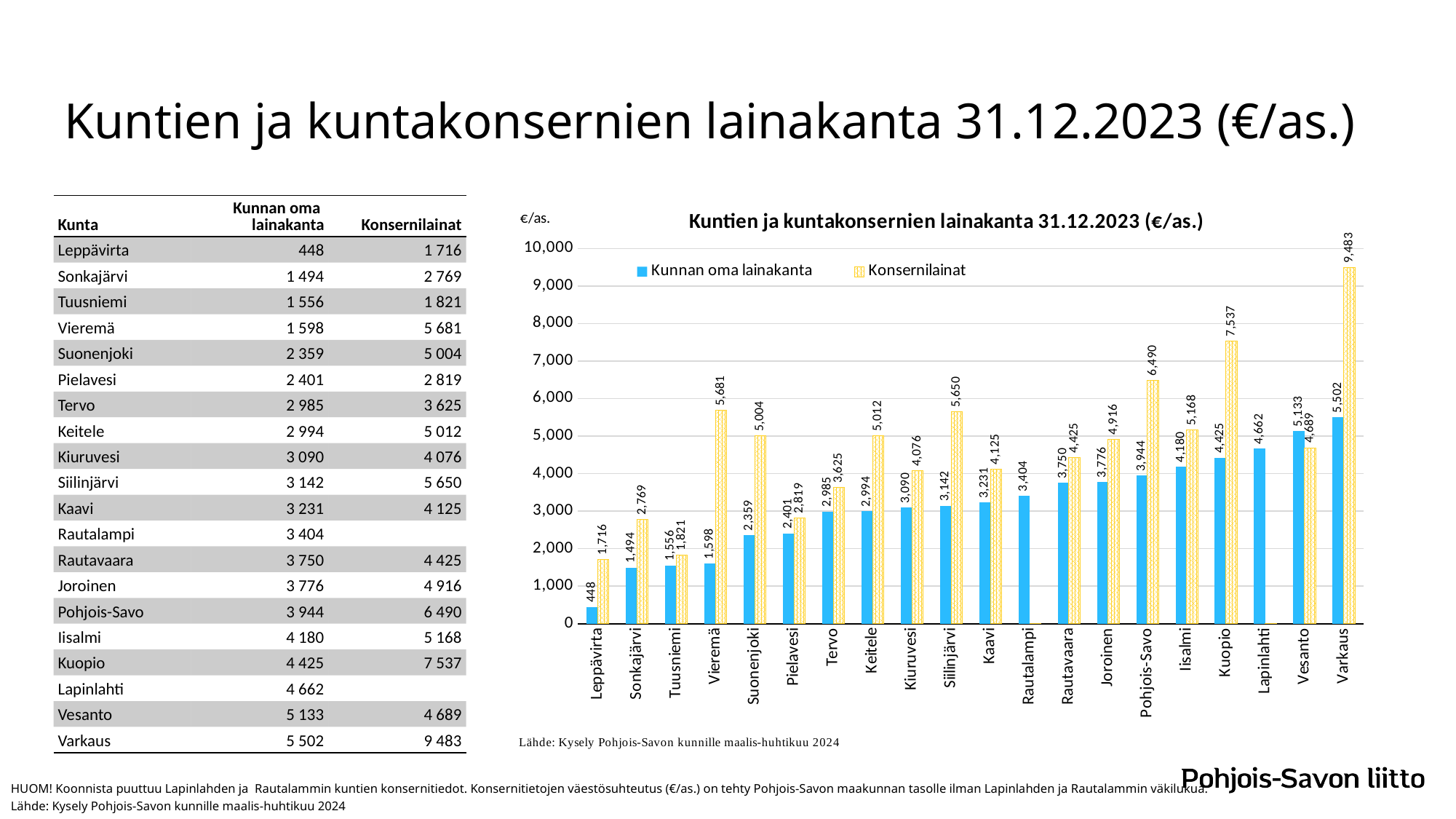
What is the difference between the Konsernilainat and Kunnan oma lainakanta values for Varkaus in the chart? 3,981 How many series does the chart legend list? 2 Which municipality has the highest Konsernilainat value in the chart? Varkaus What is the title of the chart? Kuntien ja kuntakonsernien lainakanta 31.12.2023 (€/as.) What type of chart is shown on the slide? bar chart What is the Kunnan oma lainakanta value for Leppävirta in the chart? 448 For Vesanto, which is larger in the chart: Kunnan oma lainakanta or Konsernilainat? Kunnan oma lainakanta How many municipalities (categories) are shown on the x axis of the chart? 20 Do the Kunnan oma lainakanta values rise or fall from left to right along the x axis of the chart? rise Which municipality has the lowest Kunnan oma lainakanta value in the chart? Leppävirta What is the Konsernilainat value for Kuopio in the chart? 7,537 What is the Konsernilainat value for Varkaus in the chart? 9,483